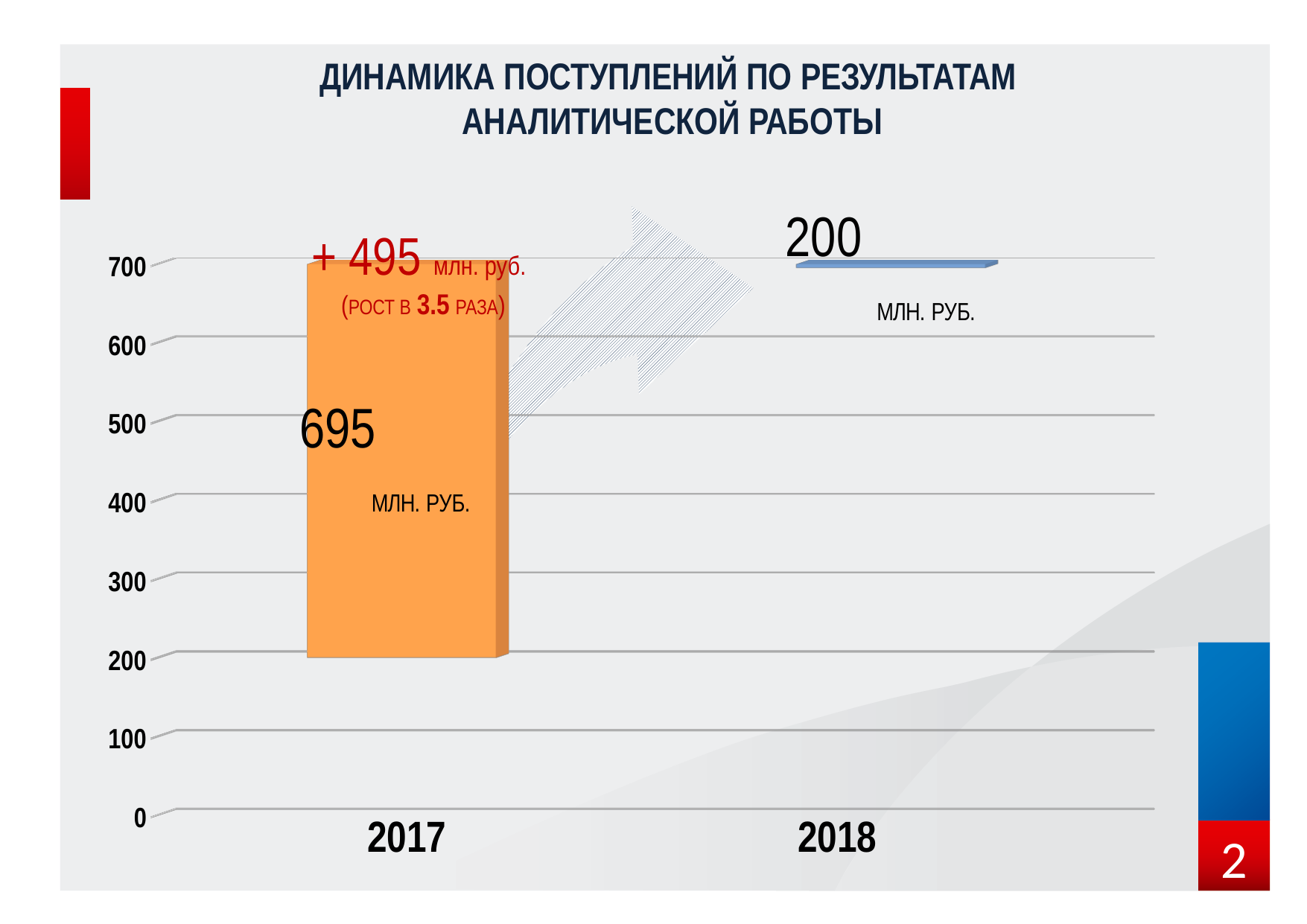
What is the difference between the two printed values, 695 and 200? 495 Which of the two printed values is larger, 695 or 200? 695 What is the highest tick value shown on the y axis? 700 Which years are shown on the x axis of the chart? 2017 and 2018 What growth in млн. руб. is stated in the red annotation on the chart? + 495 млн. руб. In what units are the values on the chart expressed? МЛН. РУБ. By what factor does the annotation say the receipts grew? 3.5 раза What is the title of the chart? ДИНАМИКА ПОСТУПЛЕНИЙ ПО РЕЗУЛЬТАТАМ АНАЛИТИЧЕСКОЙ РАБОТЫ What value is printed above the blue bar? 200 How many categories are shown on the x axis of the chart? 2 What value is printed inside the orange bar? 695 What kind of chart is shown on the slide? bar chart